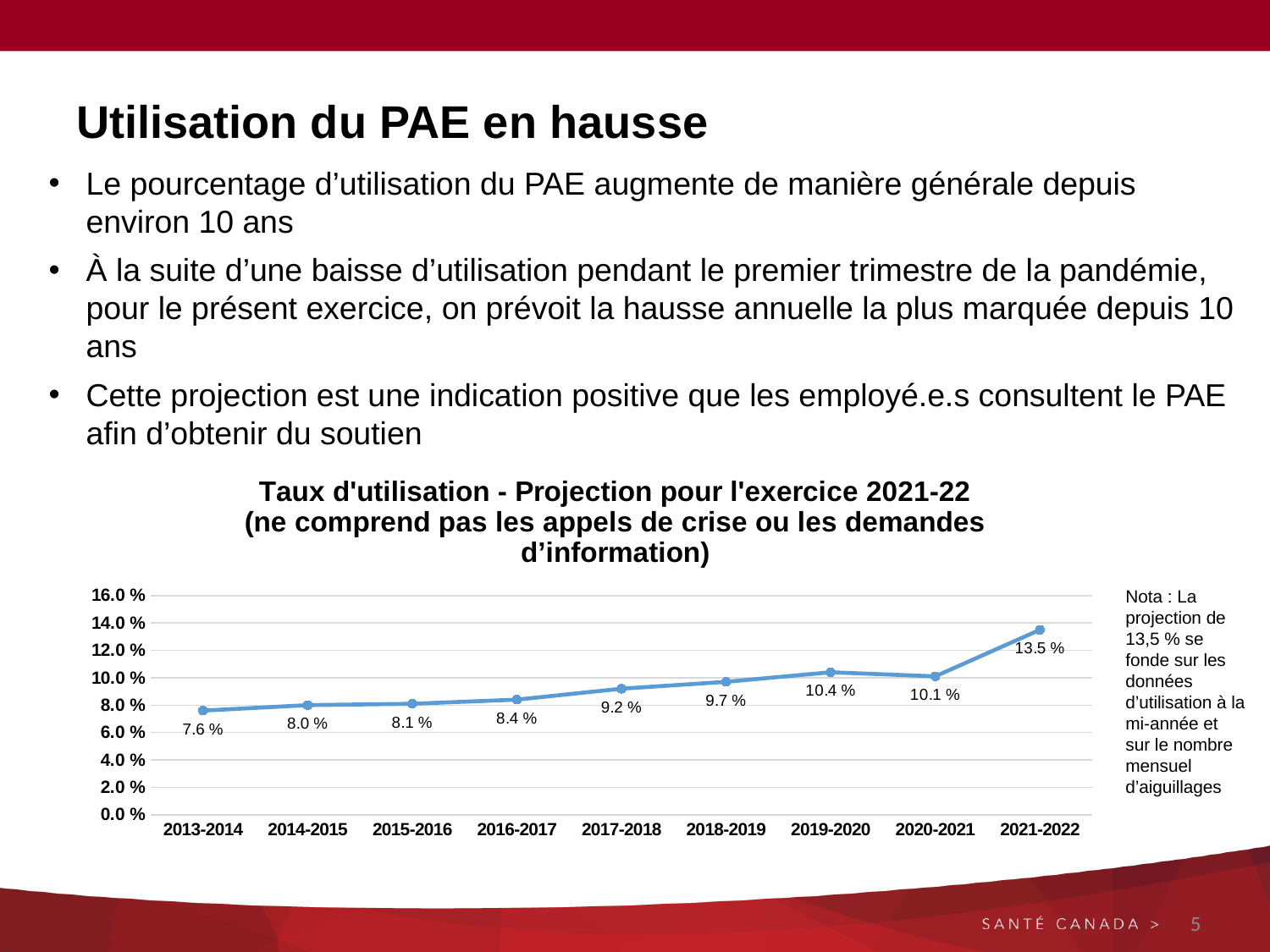
What is the utilisation rate for 2013-2014? 7.6 % Do the utilisation rates generally rise or fall from 2013-2014 to 2021-2022? rise Which year has the highest utilisation rate? 2021-2022 What is the utilisation rate for 2017-2018? 9.2 % Which is larger, the utilisation rate for 2019-2020 or for 2020-2021? 2019-2020 Which year has the lowest utilisation rate? 2013-2014 What is the projected utilisation rate for 2021-2022? 13.5 % What kind of chart is shown on the slide? line chart How many years are plotted on the chart? 9 What is the difference between the utilisation rates for 2021-2022 and 2020-2021? 3.4 % Is the value for 2018-2019 greater or less than 10.0 %? less What is the maximum value shown on the chart's vertical axis? 16.0 %